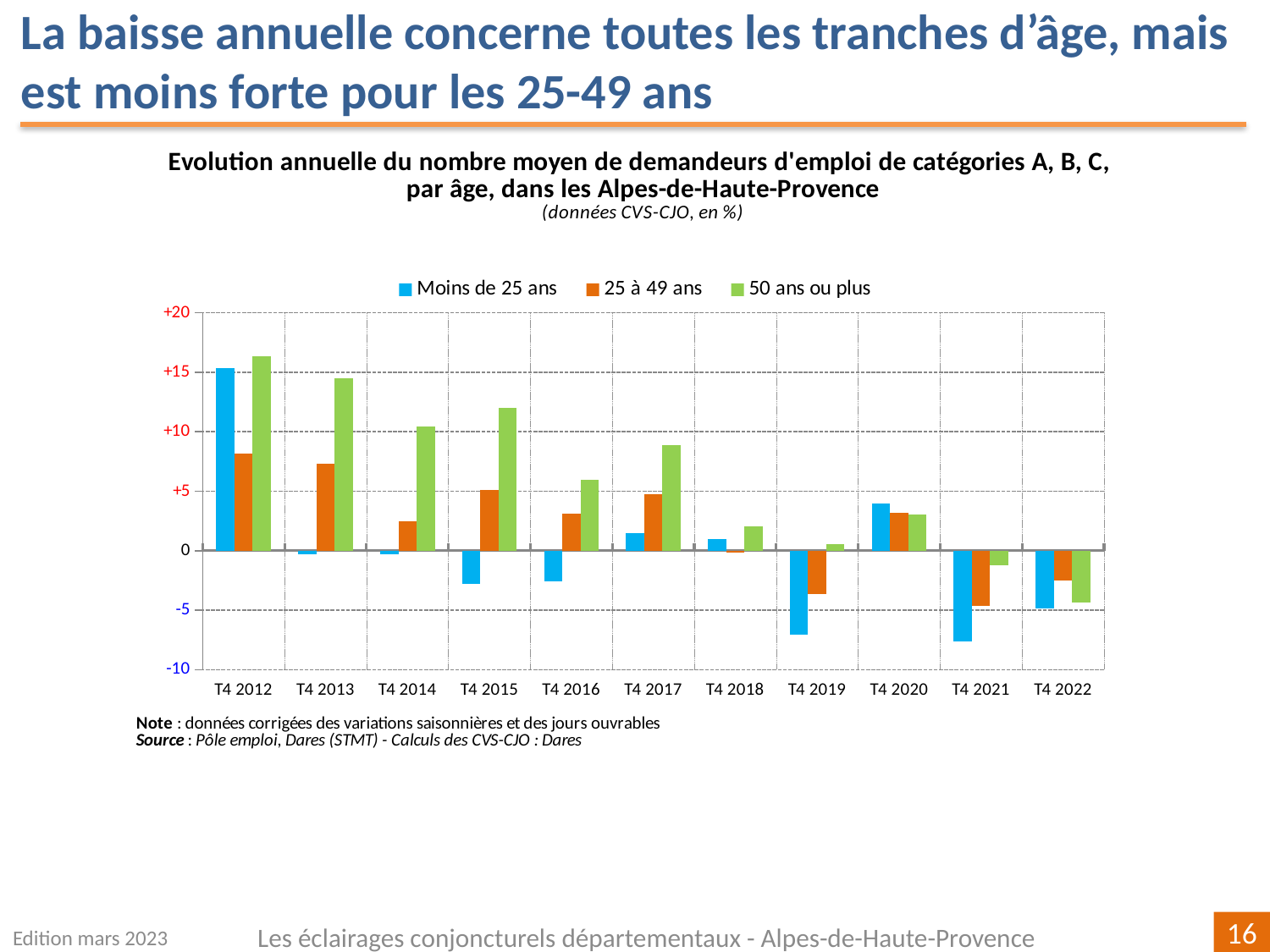
What colour represents the '25 à 49 ans' series? orange How many series does the legend list? 3 Which age group has the lowest value in T4 2021? Moins de 25 ans In T4 2015, which is larger: the value for '25 à 49 ans' or for '50 ans ou plus'? 50 ans ou plus Does the value for '50 ans ou plus' rise or fall from T4 2012 to T4 2014? fall Is the value for '50 ans ou plus' in T4 2012 greater or less than +15? greater Is the value for 'Moins de 25 ans' in T4 2019 greater or less than -5? less What kind of chart is shown on the slide? bar chart Which age group has the highest value in T4 2013? 50 ans ou plus How many quarters (categories) are shown along the x axis? 11 Is the value for '25 à 49 ans' in T4 2014 greater or less than +5? less Which department does the chart title say the data refers to? Alpes-de-Haute-Provence